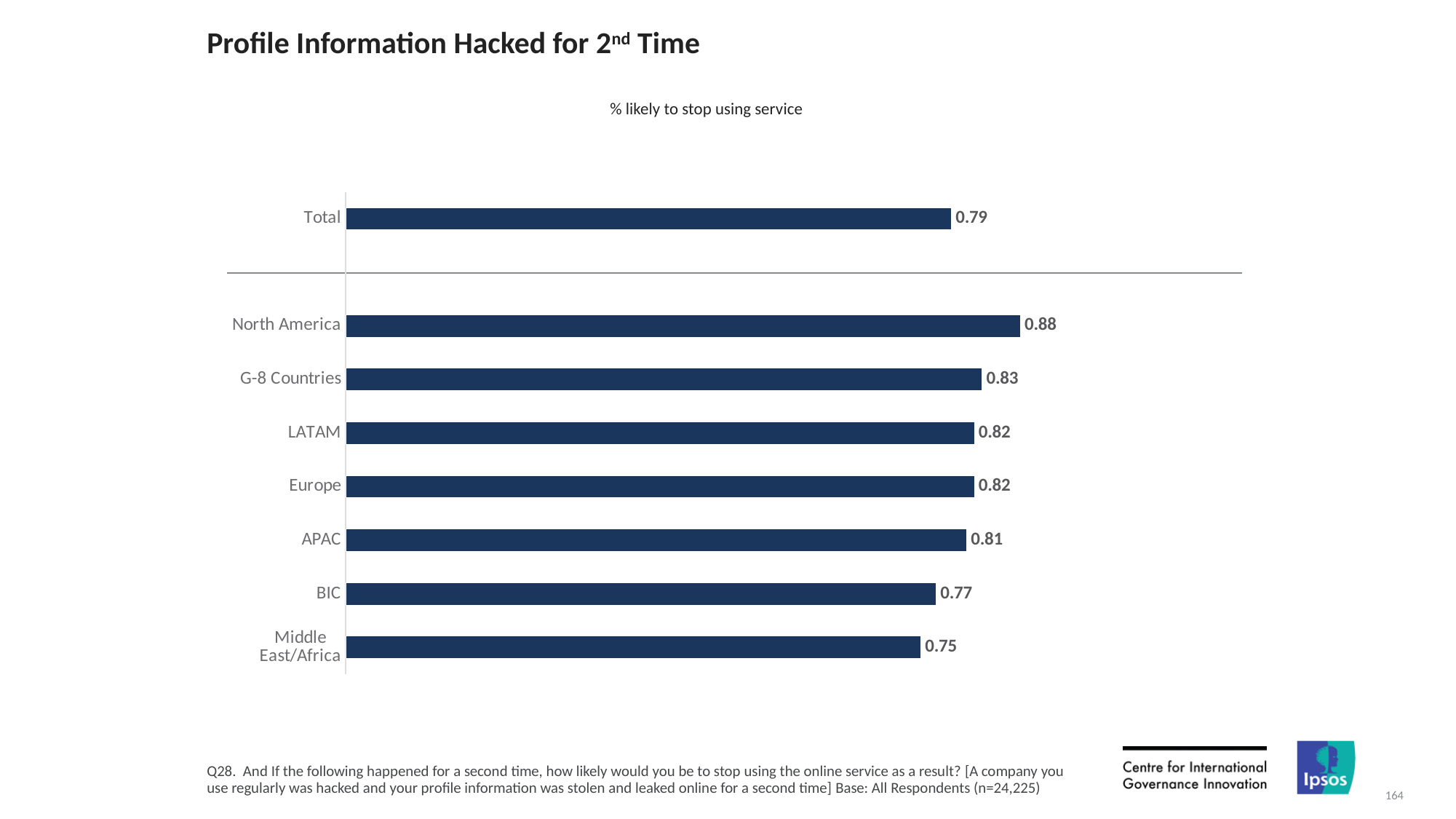
What is the value for North America? 0.88 What is the difference between the values for North America and Middle East/Africa? 0.13 What is the value for BIC? 0.77 What kind of chart is shown on the slide? Bar chart What is the value for Total? 0.79 Which category has the lowest value? Middle East/Africa Which category has the highest value? North America How many categories are shown in the chart, including Total? 8 Which is larger, the value for G-8 Countries or the value for BIC? G-8 Countries What is the subtitle shown above the chart? % likely to stop using service What is the value for Middle East/Africa? 0.75 What is the difference between the values for G-8 Countries and APAC? 0.02